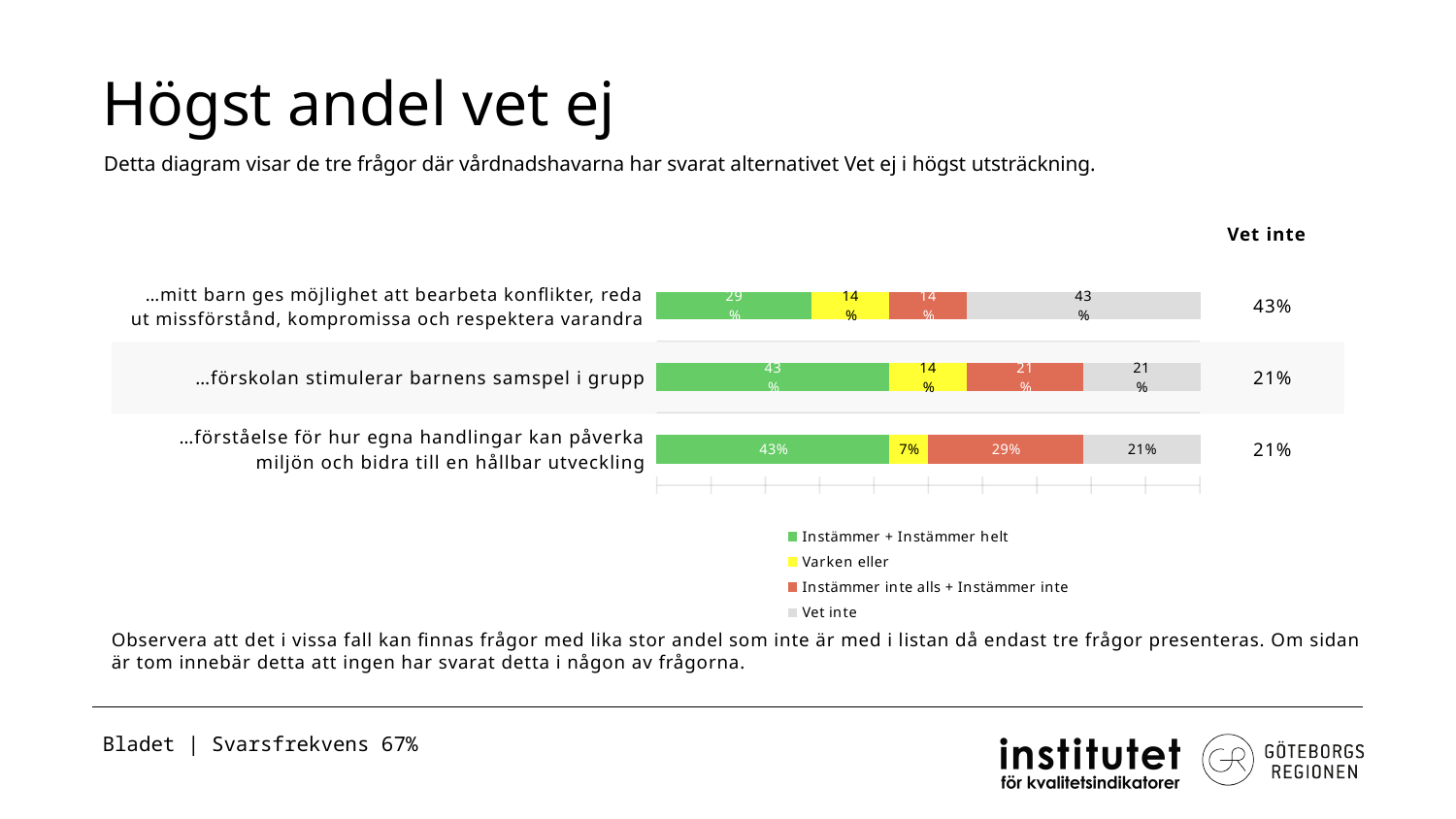
Which legend entry is shown in grey? Vet inte What is the 'Instämmer + Instämmer helt' value for '…förskolan stimulerar barnens samspel i grupp'? 43% What kind of chart is shown on the slide? bar chart How many series does the legend list? 4 Which category has the lowest 'Varken eller' share? …förståelse för hur egna handlingar kan påverka miljön och bidra till en hållbar utveckling How many categories (questions) are plotted in the chart? 3 What is the 'Varken eller' value for '…förståelse för hur egna handlingar kan påverka miljön och bidra till en hållbar utveckling'? 7% What is the 'Vet inte' value for '…mitt barn ges möjlighet att bearbeta konflikter, reda ut missförstånd, kompromissa och respektera varandra'? 43% What is the 'Instämmer inte alls + Instämmer inte' value for '…förståelse för hur egna handlingar kan påverka miljön och bidra till en hållbar utveckling'? 29% What is the difference between the 'Vet inte' value for '…mitt barn ges möjlighet att bearbeta konflikter…' and for '…förskolan stimulerar barnens samspel i grupp'? 22% Which is larger: the 'Instämmer inte alls + Instämmer inte' value for '…förskolan stimulerar barnens samspel i grupp' or for '…förståelse för hur egna handlingar kan påverka miljön…'? …förståelse för hur egna handlingar kan påverka miljön och bidra till en hållbar utveckling Which category has the highest 'Vet inte' share? …mitt barn ges möjlighet att bearbeta konflikter, reda ut missförstånd, kompromissa och respektera varandra